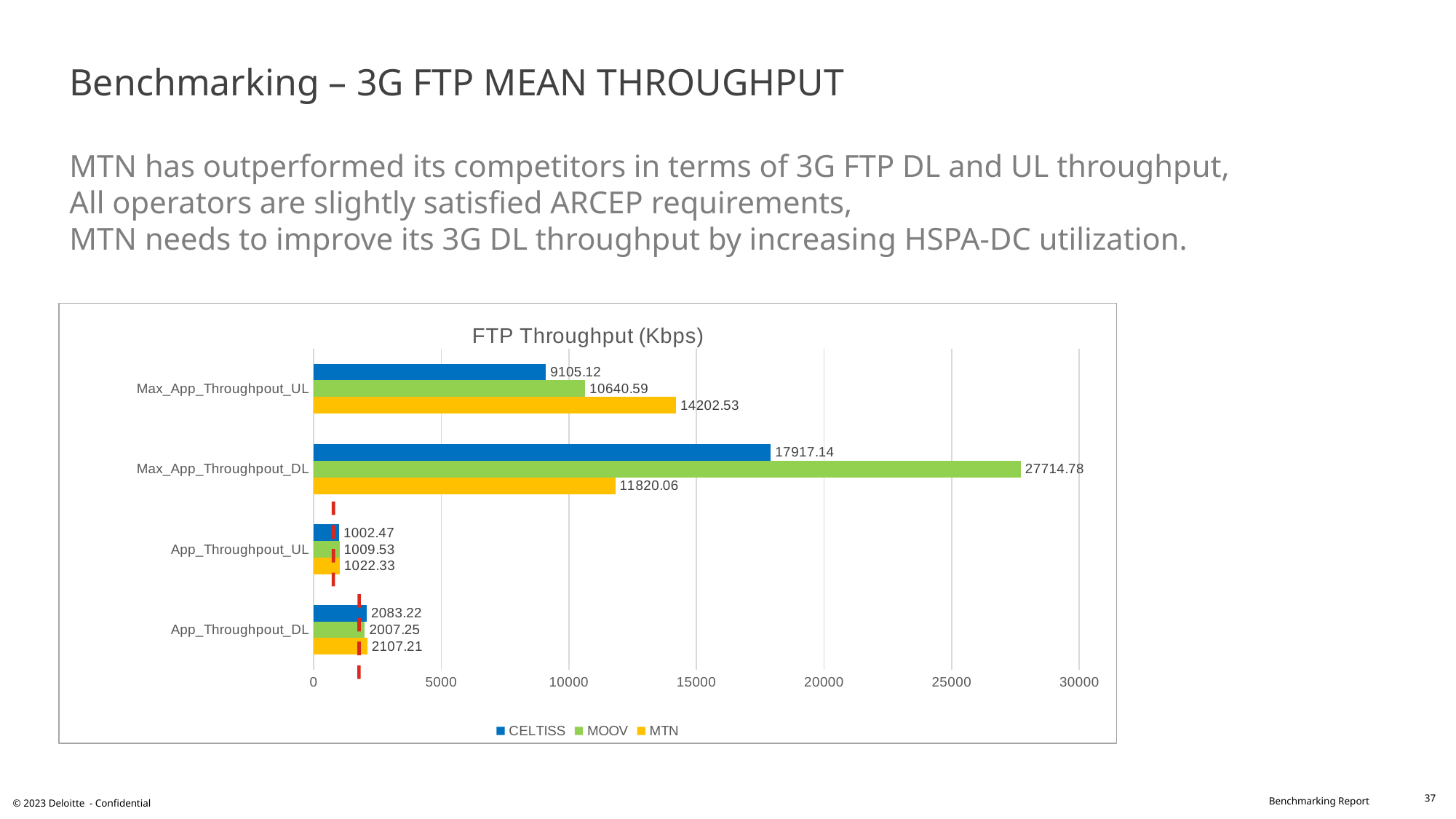
Is the MOOV value for Max_App_Throughpout_DL greater or less than 25000? greater For Max_App_Throughpout_DL, which is larger: the CELTISS value or the MTN value? CELTISS What is the MOOV value for Max_App_Throughpout_DL? 27714.78 What kind of chart is shown on the slide? Bar chart What is the CELTISS value for App_Throughpout_DL? 2083.22 What is the MTN value for Max_App_Throughpout_UL? 14202.53 What is the MTN value for App_Throughpout_UL? 1022.33 What is the difference between the MTN and CELTISS values for Max_App_Throughpout_UL? 5097.41 Which operator has the lowest Max_App_Throughpout_UL value? CELTISS What is the difference between the MOOV and CELTISS values for Max_App_Throughpout_DL? 9797.64 Which operator has the highest Max_App_Throughpout_DL value? MOOV How many series does the legend list? 3